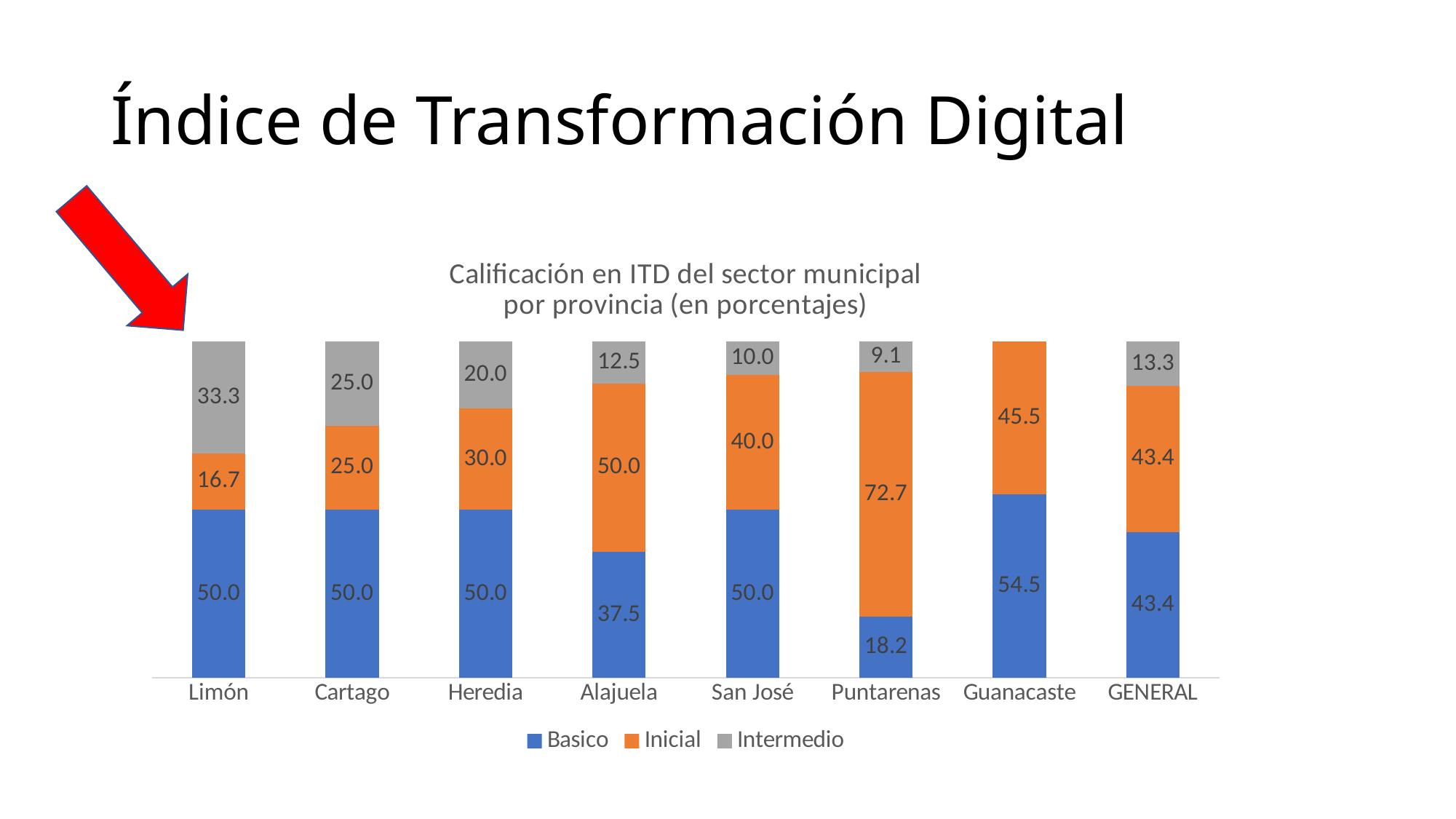
Which category has the lowest Basico value? Puntarenas Which is larger, the Intermedio value for Cartago or the Intermedio value for Alajuela? Cartago What is the difference between the Inicial values for Puntarenas and Limón? 56.0 What is the total of the stacked bar for GENERAL? 100.1 What is the Intermedio value for Limón? 33.3 What is the Inicial value for Guanacaste? 45.5 Which category has the highest Inicial value? Puntarenas What is the Basico value for Puntarenas? 18.2 How many series does the legend list? 3 What is the title of the chart? Calificación en ITD del sector municipal por provincia (en porcentajes) What type of chart is shown on the slide? stacked bar chart How many categories are shown on the x axis? 8